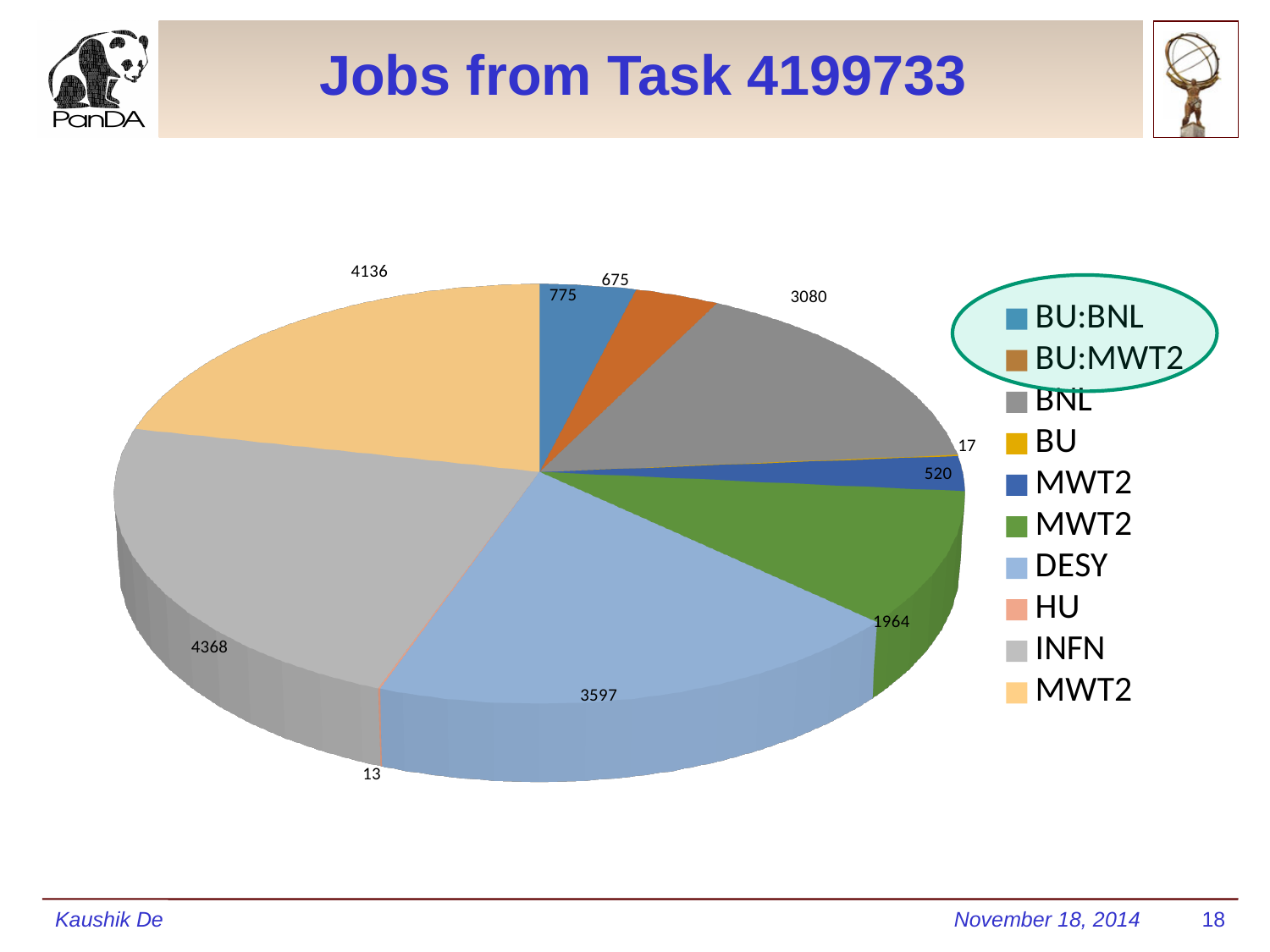
Which category has the largest slice? INFN What is the value of the HU slice? 13 What is the value of the DESY slice? 3597 What is the value of the BU:BNL slice? 775 What is the value of the BNL slice? 3080 Which is larger, the BU:BNL slice or the BU:MWT2 slice? BU:BNL What is the value of the INFN slice? 4368 Which category has the smallest slice? HU What type of chart is shown on the slide? pie chart What is the difference between the INFN slice and the DESY slice? 771 What is the title of the slide containing the chart? Jobs from Task 4199733 How many slices does the pie chart have? 10